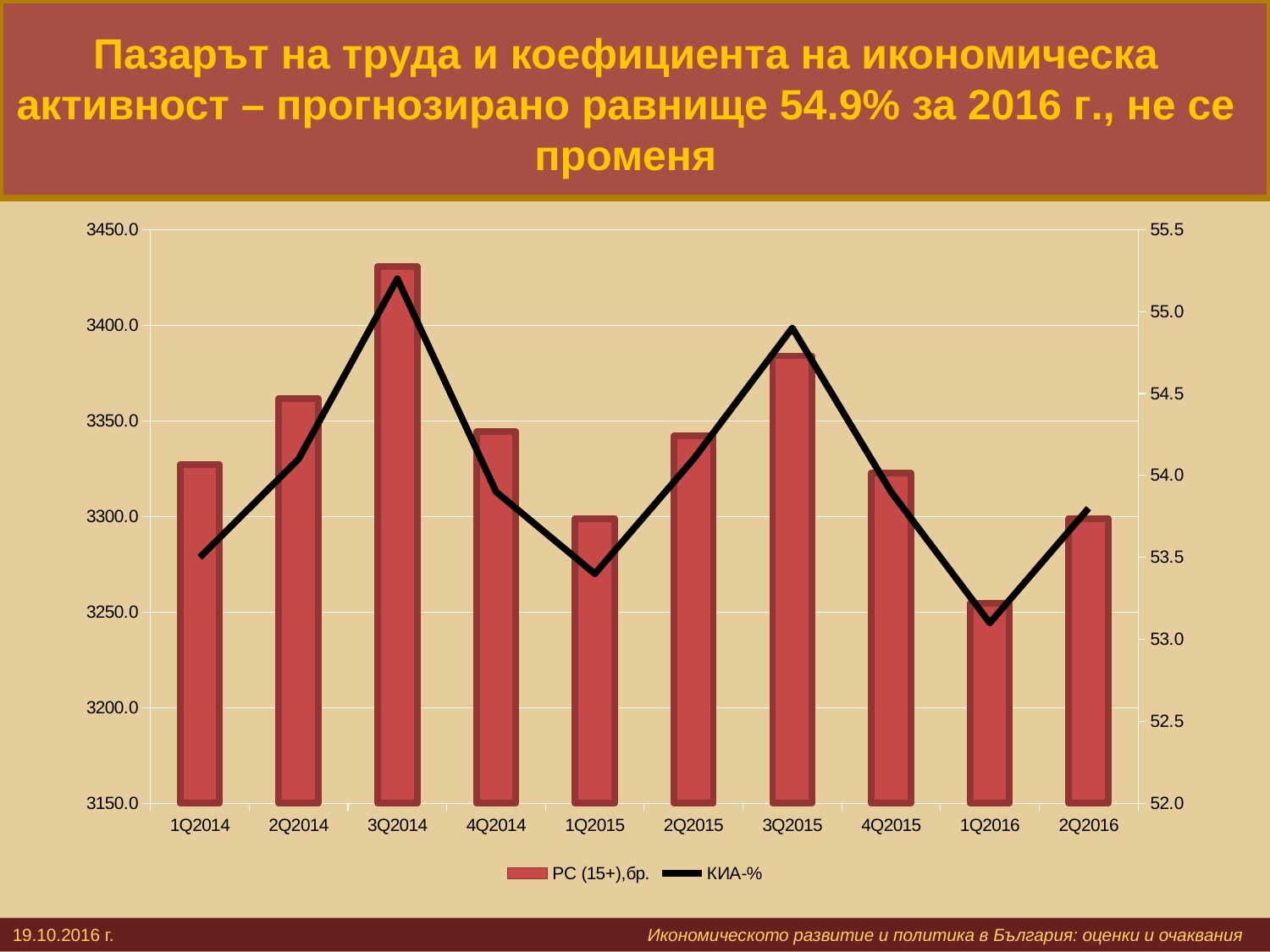
Which quarter has a higher РС (15+),бр. bar, 2Q2015 or 3Q2015? 3Q2015 Is the РС (15+),бр. value for 3Q2014 greater or less than 3400.0? greater Is the РС (15+),бр. value for 1Q2016 greater or less than 3300.0? less Which quarter has the highest bar for РС (15+),бр.? 3Q2014 What kind of chart is shown on the slide? A combined bar and line chart In which quarter does the КИА-% line reach its lowest point? 1Q2016 How many quarters are shown on the x axis of the chart? 10 Is the КИА-% value for 3Q2015 greater or less than 54.5? greater How many series does the chart legend list? 2 Do the РС (15+),бр. bars rise or fall from 3Q2015 to 1Q2016? fall In which quarter does the КИА-% line reach its highest point? 3Q2014 Which quarter has the lowest bar for РС (15+),бр.? 1Q2016